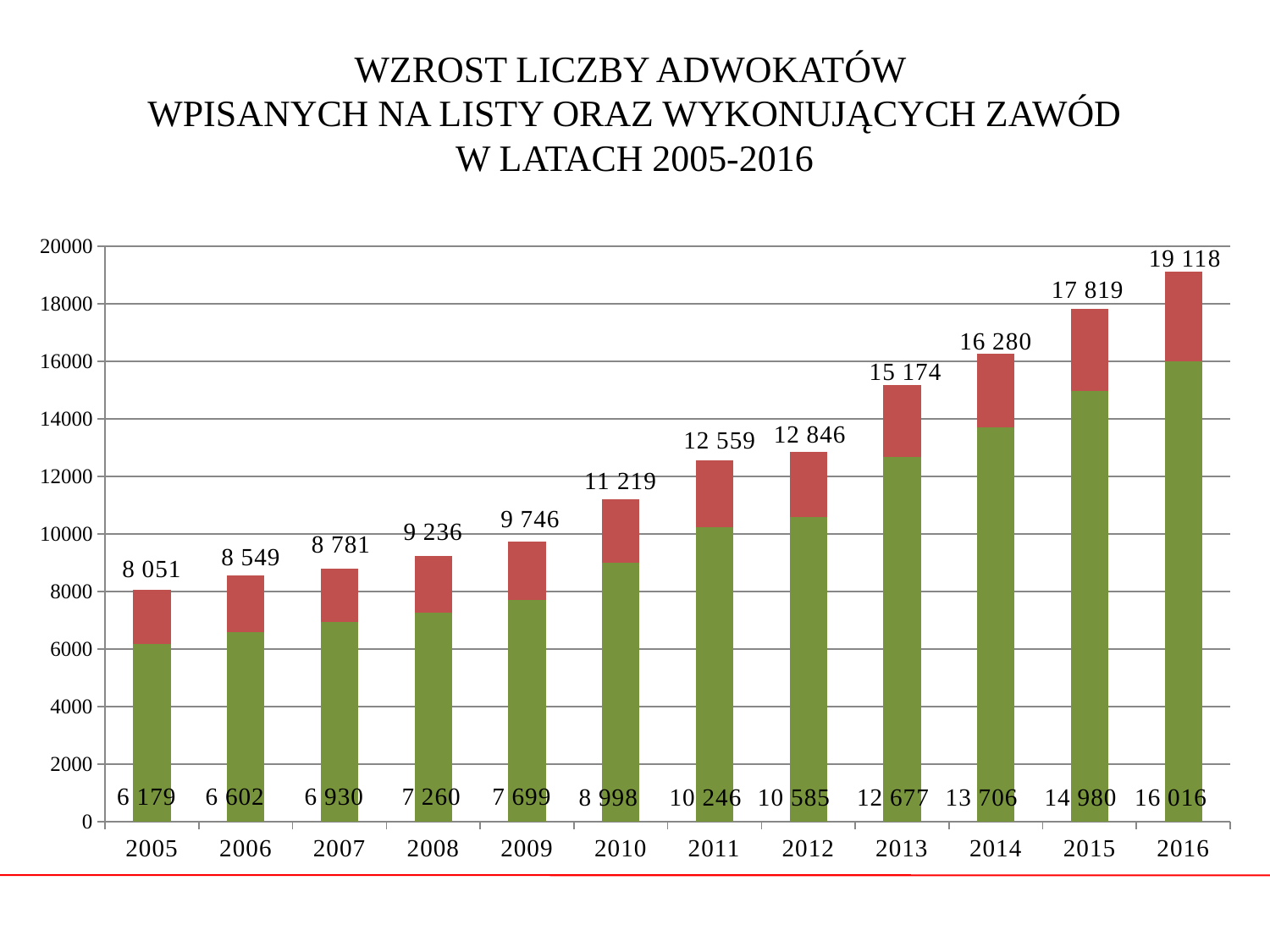
Is the total height of the bar for 2013 greater or less than 14000? greater What is the value printed at the top of the bar for 2016? 19 118 What kind of chart is shown on the slide? Stacked bar chart Do the bar totals rise or fall from 2005 to 2016? Rise What is the difference between the top label of the 2016 bar (19 118) and the top label of the 2005 bar (8 051)? 11 067 What is the value printed inside the green segment of the bar for 2010? 8 998 How many years are shown along the x axis of the chart? 12 What is the value printed at the top of the bar for 2009? 9 746 Which year has the tallest bar? 2016 Which year has the shortest bar? 2005 What is the difference between the top label (19 118) and the green segment label (16 016) of the 2016 bar? 3 102 Which bar is taller, 2011 or 2012? 2012